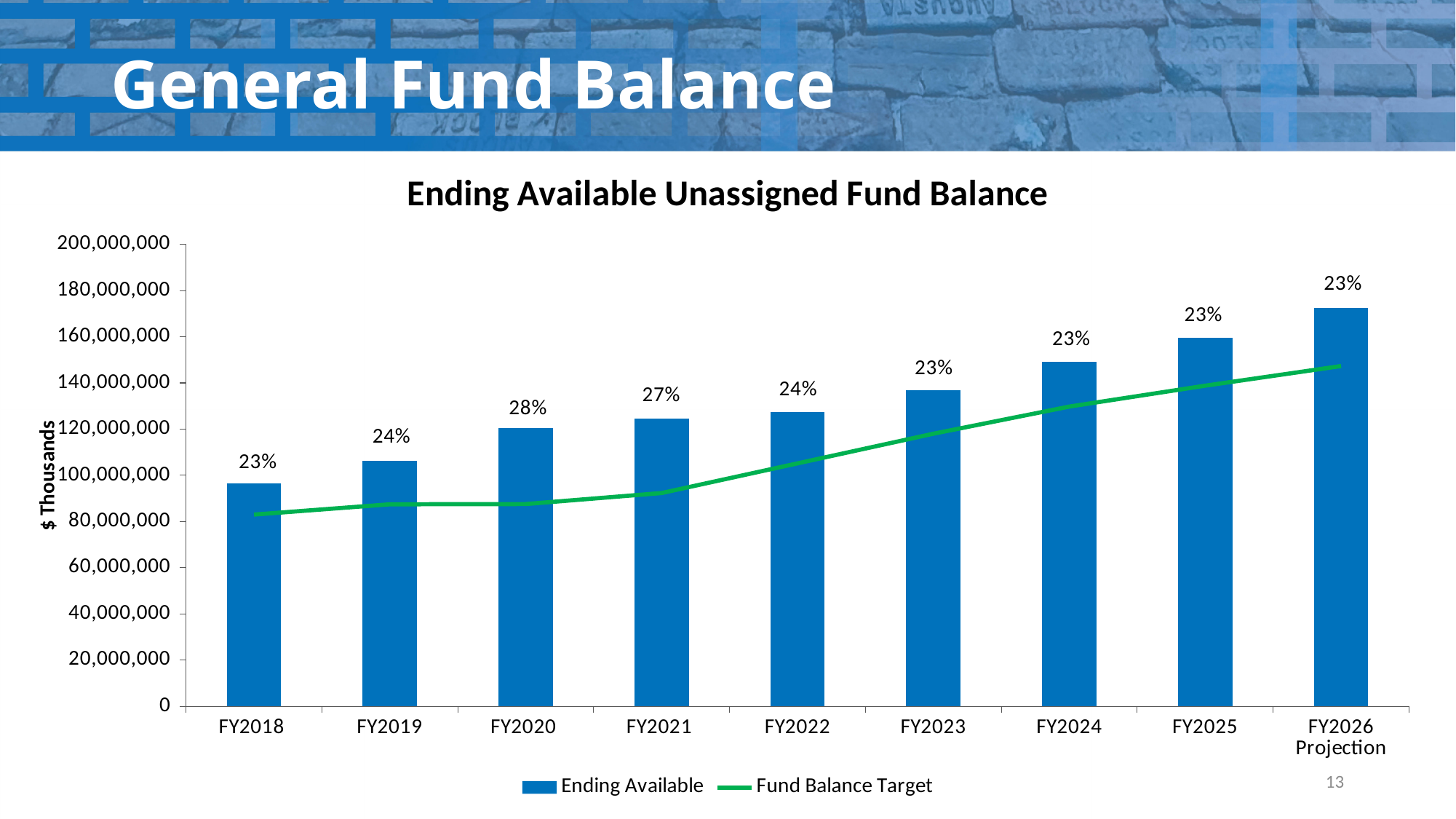
Do the Ending Available bars generally rise or fall from FY2018 to FY2026 Projection? rise How many percentage points higher is the FY2020 label than the FY2018 label? 5 percentage points Is the Ending Available bar for FY2026 Projection greater or less than 160,000,000? greater How many fiscal years are shown on the x axis? 9 Which fiscal year has the highest percentage label on its bar? FY2020 Is the Ending Available bar for FY2018 greater or less than 100,000,000? less Which is larger, the Ending Available bar for FY2026 Projection or for FY2018? FY2026 Projection What percentage label is shown above the FY2026 Projection bar? 23% What is the title of the chart? Ending Available Unassigned Fund Balance How many series does the legend list? 2 What percentage label is shown above the FY2021 bar? 27% What percentage label is shown above the FY2020 bar? 28%